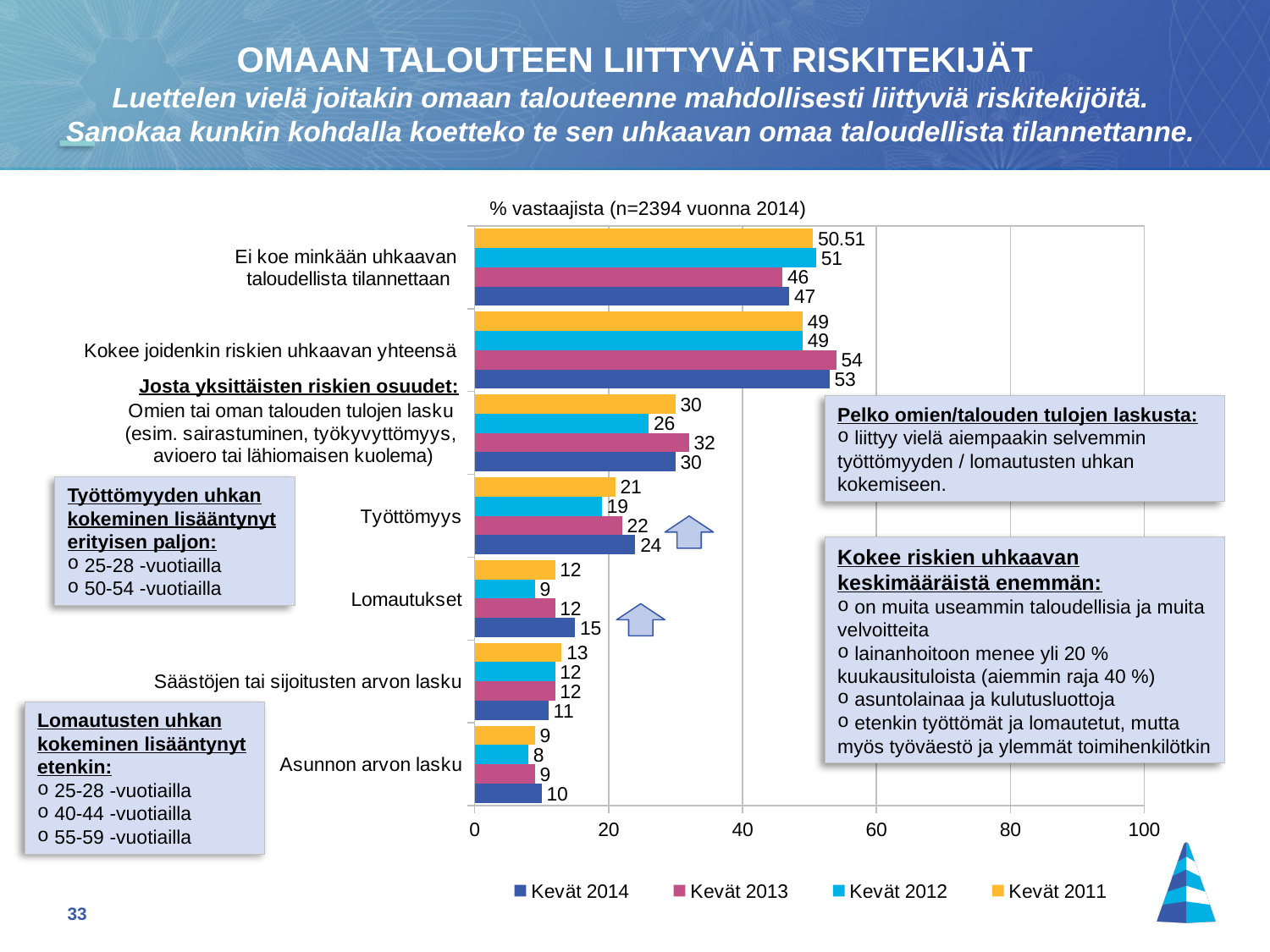
For Omien tai oman talouden tulojen lasku, which is larger: the Kevät 2013 value or the Kevät 2012 value? Kevät 2013 What type of chart is shown on the slide? bar chart What is the difference between the Kevät 2014 and Kevät 2012 values for Lomautukset? 6 Which category has the lowest Kevät 2014 value? Asunnon arvon lasku What is the Kevät 2013 value for Kokee joidenkin riskien uhkaavan yhteensä? 54 What is the Kevät 2014 value for Työttömyys? 24 What is the Kevät 2012 value for Lomautukset? 9 What is the title of the chart? % vastaajista (n=2394 vuonna 2014) How many categories are plotted on the chart? 7 What is the Kevät 2011 value for Ei koe minkään uhkaavan taloudellista tilannettaan? 50.51 How many series does the chart legend list? 4 Which category has the highest Kevät 2013 value? Kokee joidenkin riskien uhkaavan yhteensä